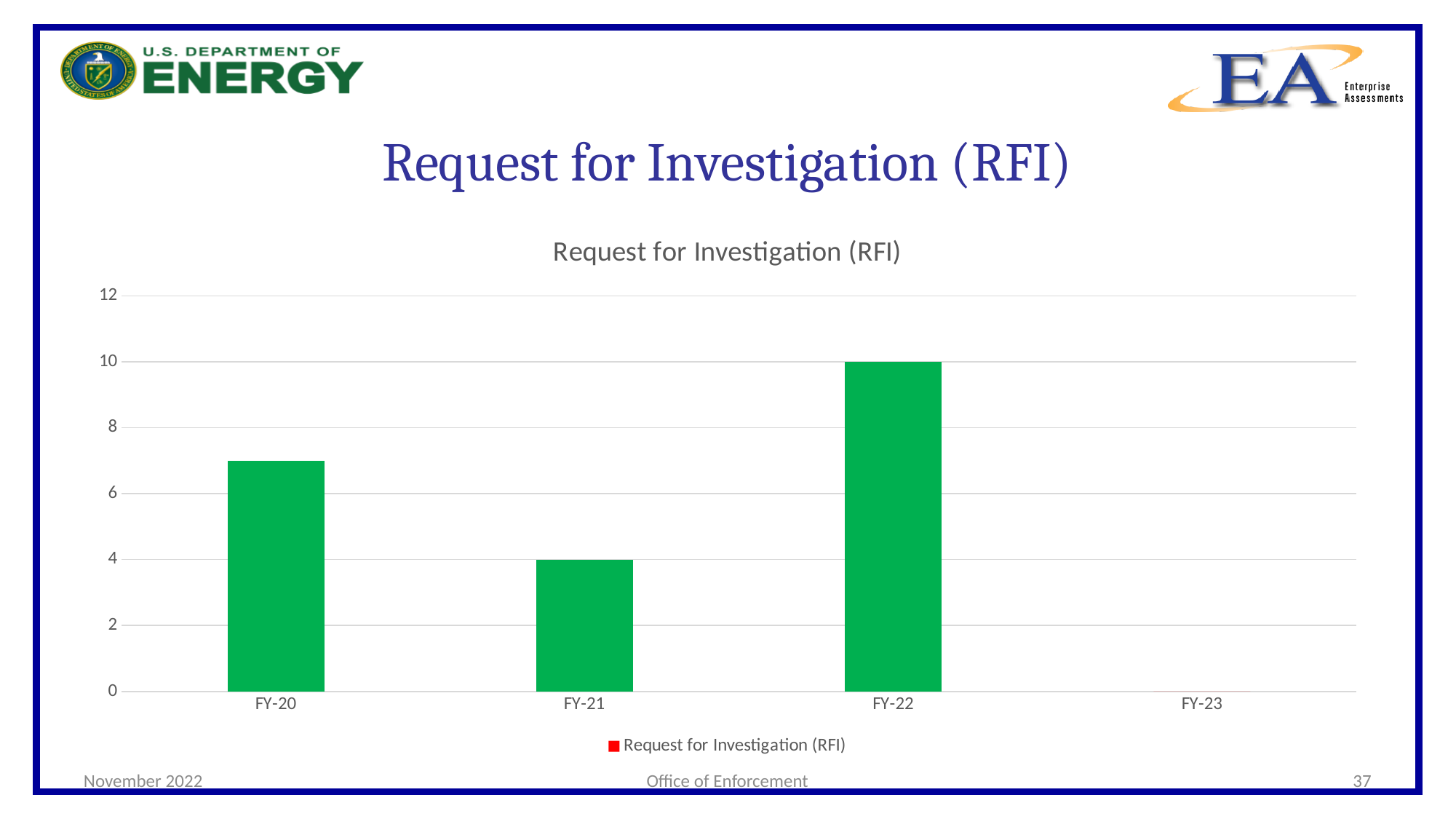
Which is larger, the value for FY-20 or the value for FY-21? FY-20 Which fiscal year has the tallest bar? FY-22 Which fiscal year has the shortest visible bar? FY-21 Does the value rise or fall from FY-21 to FY-22? rise What type of chart is shown on the slide? bar chart How many fiscal year categories are shown on the x axis? 4 Is the value for FY-20 greater or less than 6? greater What is the difference between the values for FY-22 and FY-21? 6 How many series does the legend list? 1 What is the value for FY-21? 4 What is the value for FY-22? 10 Is the value for FY-20 greater or less than 8? less